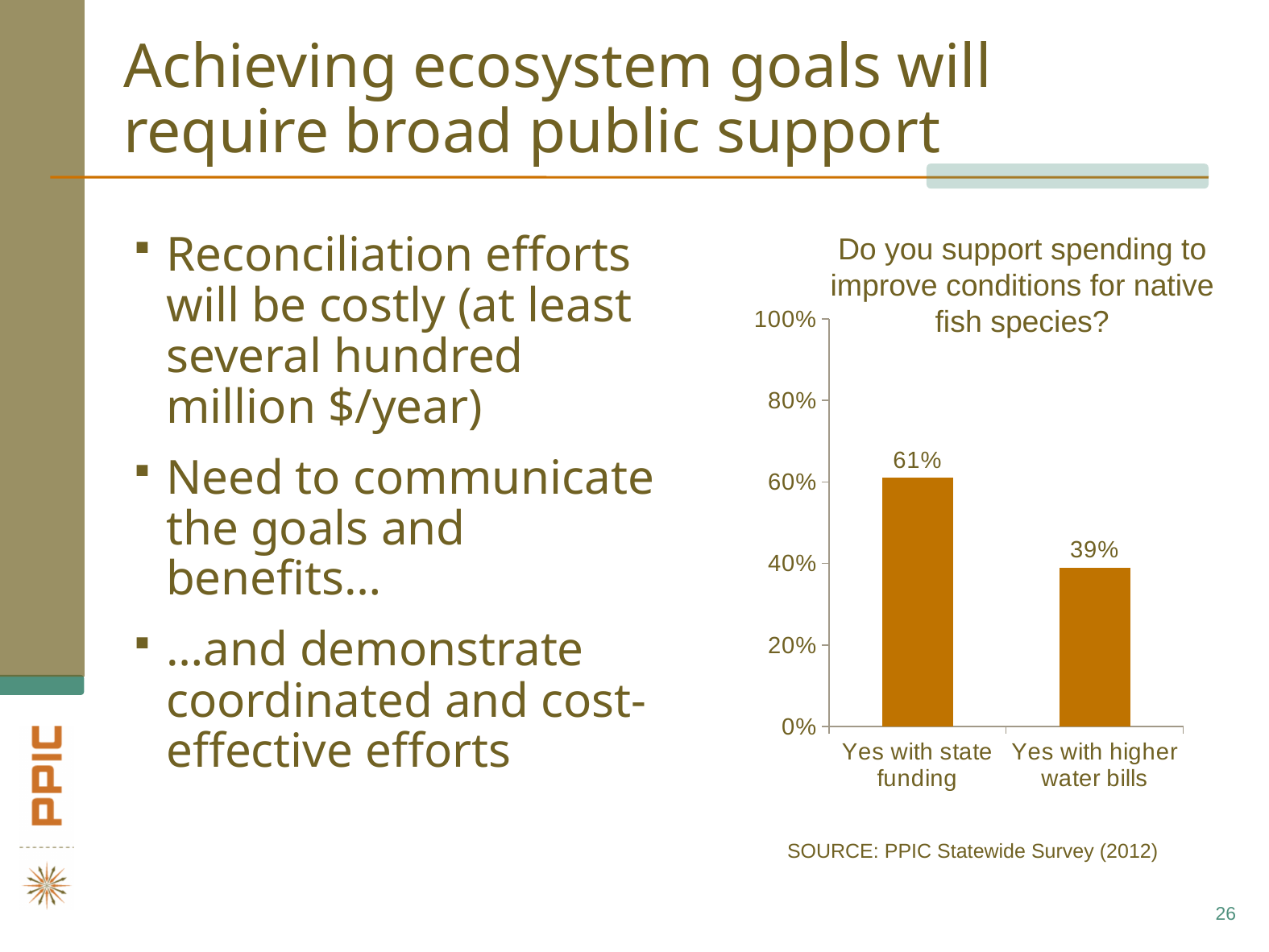
What percentage of respondents said yes with state funding? 61% Which is larger: the value for yes with state funding or the value for yes with higher water bills? Yes with state funding Which category has the lowest value? Yes with higher water bills What is the title of the chart? Do you support spending to improve conditions for native fish species? Is the value for yes with higher water bills greater or less than 40%? less What percentage of respondents said yes with higher water bills? 39% How many categories are shown in the chart? 2 Which category has the highest value? Yes with state funding What kind of chart is shown on the slide? Bar chart What is the source cited for the chart? PPIC Statewide Survey (2012) Is the value for yes with state funding greater or less than 60%? greater What is the difference between the value for yes with state funding and the value for yes with higher water bills? 22%